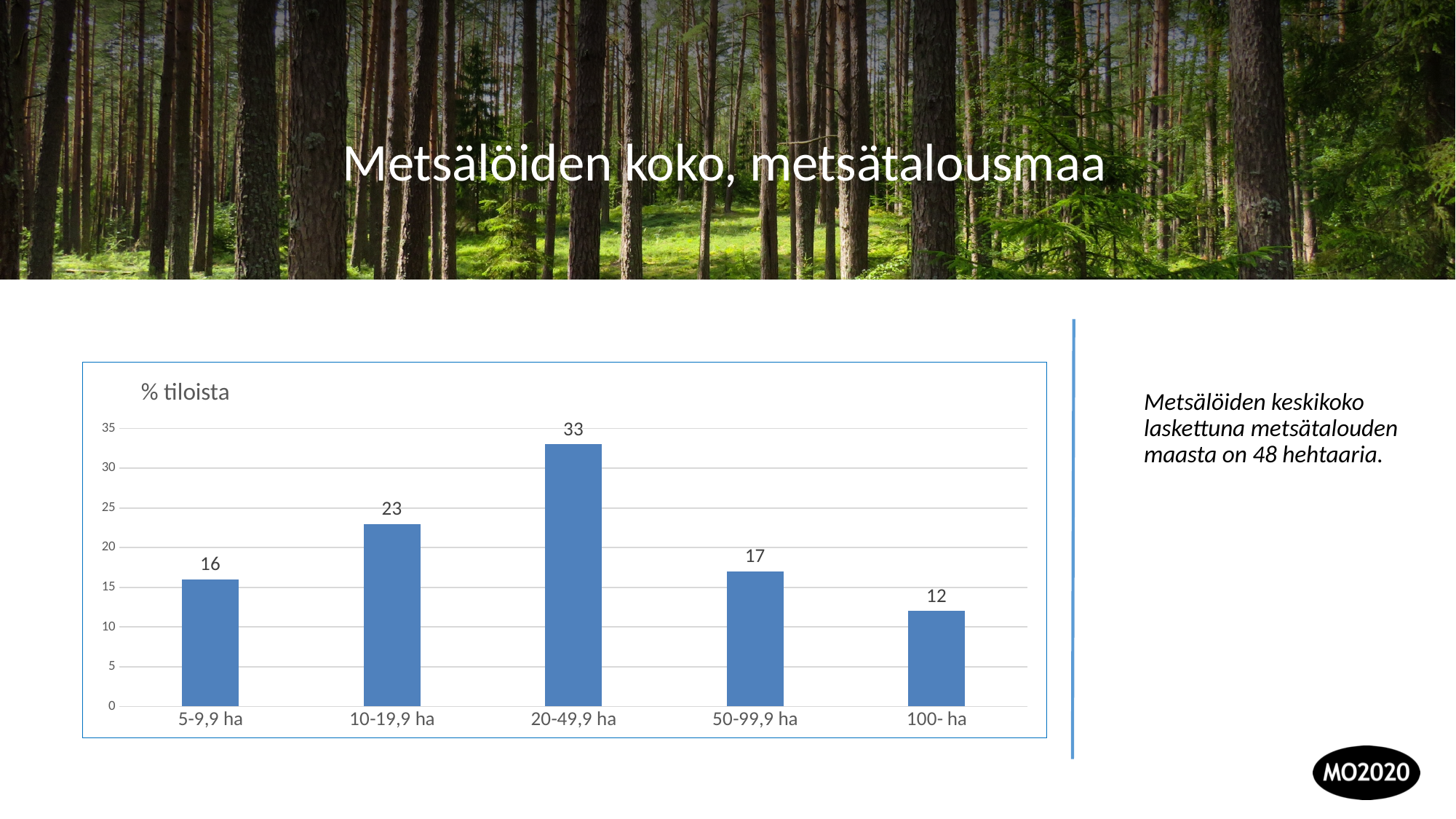
What is the difference between the values for 10-19,9 ha and 50-99,9 ha? 6 What is the value for the 20-49,9 ha category? 33 Which category has the lowest value? 100- ha What is the value for the 100- ha category? 12 What kind of chart is shown on the slide? bar chart Which is larger, the value for 5-9,9 ha or the value for 50-99,9 ha? 50-99,9 ha What is the title of the chart? % tiloista Is the value for 10-19,9 ha greater or less than 20? greater What is the value for the 5-9,9 ha category? 16 Which category has the highest value? 20-49,9 ha What is the difference between the highest and lowest values in the chart? 21 How many categories are shown on the x axis? 5